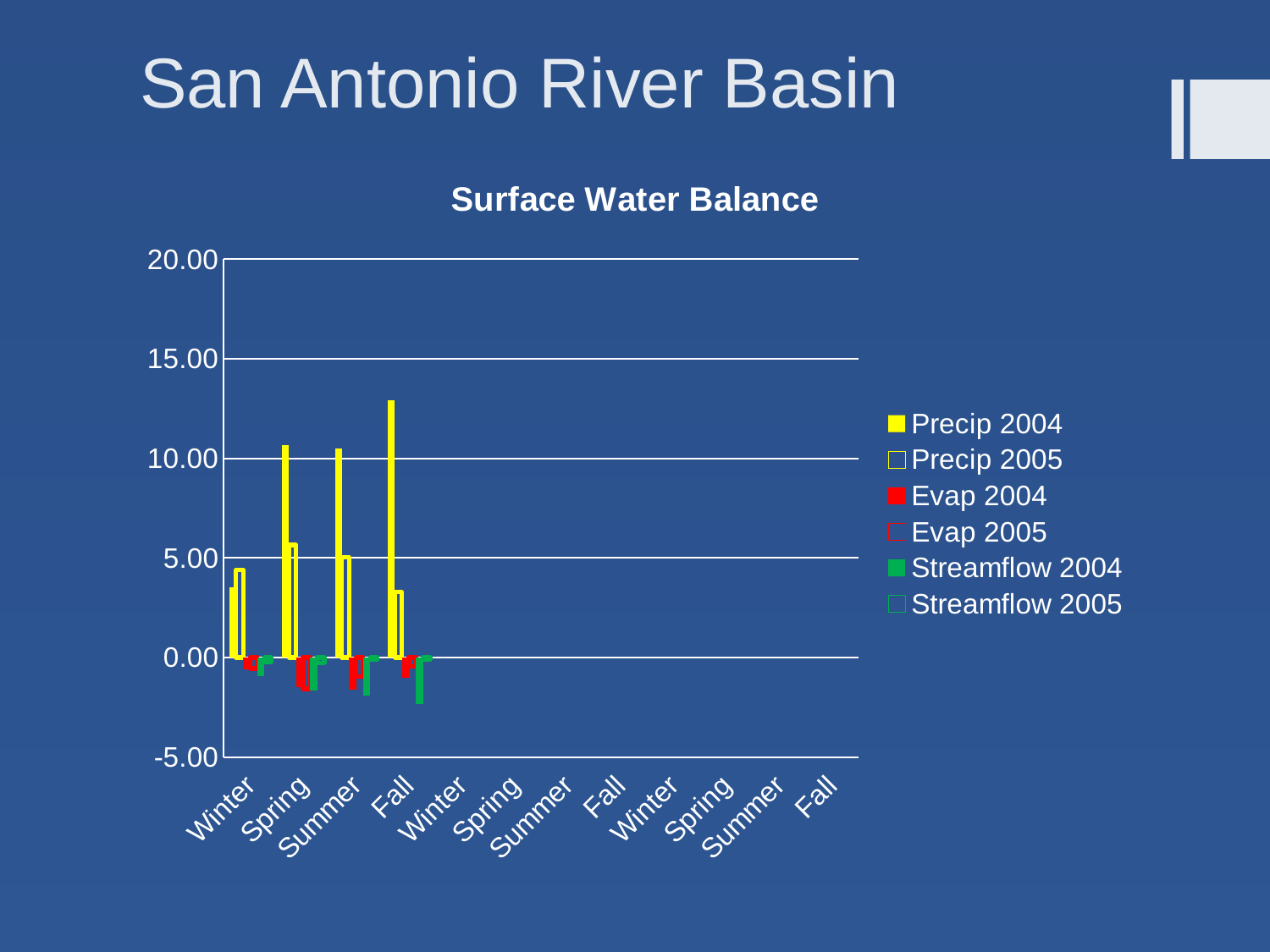
How many series does the chart's legend list? 6 Is the Precip 2005 value for Fall greater or less than 5.00? less In which season is the Precip 2004 value highest? Fall Is the Precip 2004 value for Winter greater or less than 5.00? less Which is larger, the Precip 2005 value for Spring or for Fall? Spring In which season is the Precip 2004 value lowest? Winter What is the title of the chart? Surface Water Balance Which colour represents Precip 2004 in the legend? yellow Is the Precip 2004 value for Fall greater or less than 10.00? greater How many category labels are shown along the x axis? 12 What kind of chart is shown on the slide? bar chart